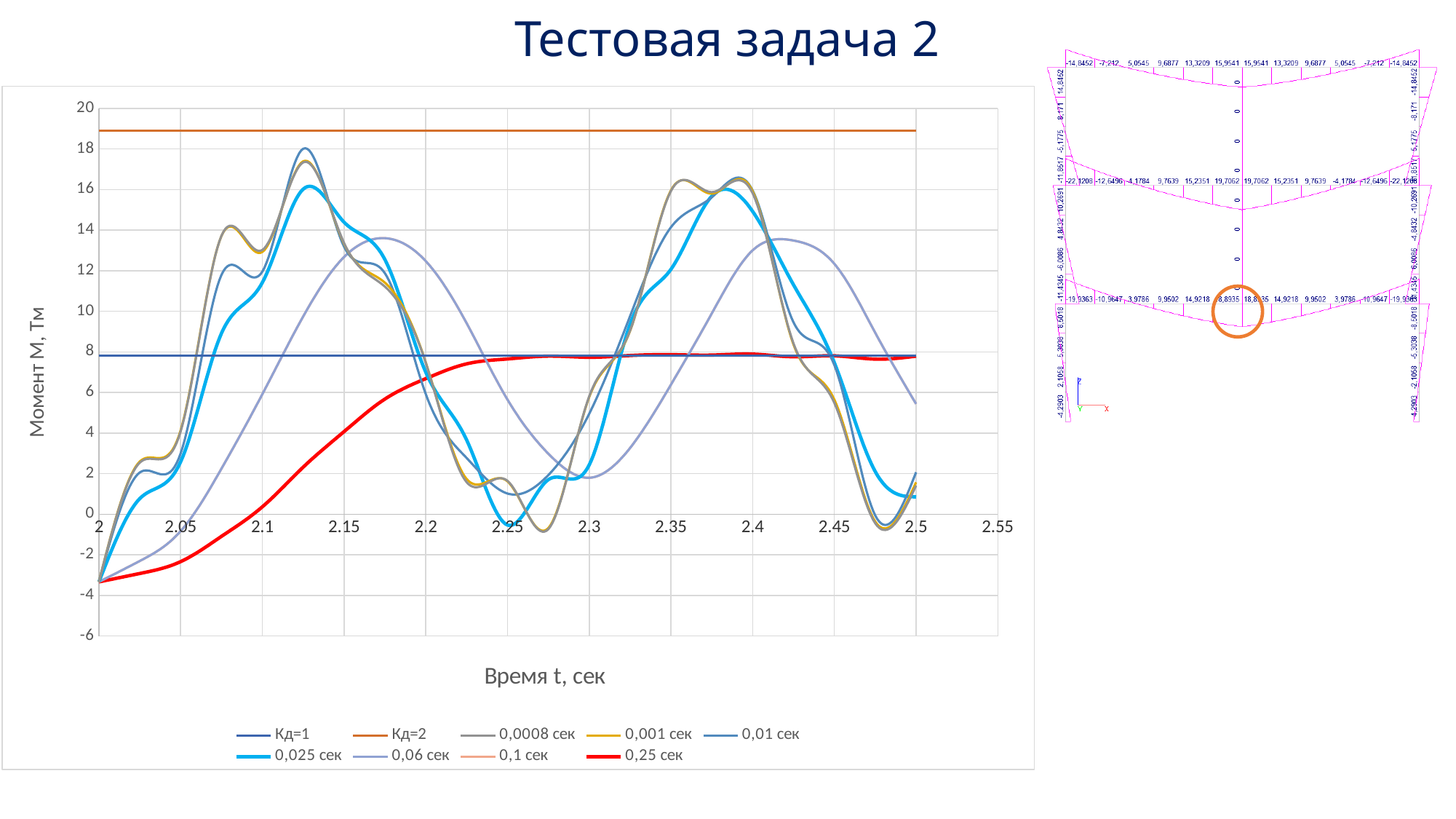
Is the value of the 0,25 сек series at t = 2.1 greater or less than 2? less Is the value of the Кд=1 series greater or less than 8? less Which series has the highest value on the chart? Кд=2 What is the title of the x axis of the chart? Время t, сек How many series does the chart legend list? 9 Does the 0,25 сек series rise or fall between t = 2 and t = 2.3? rise Is the value of the 0,25 сек series at t = 2.2 greater or less than 8? less At t = 2.1, which series has the larger value: 0,25 сек or 0,06 сек? 0,06 сек What is the title of the y axis of the chart? Момент М, Тм What kind of chart is shown on the slide? line chart